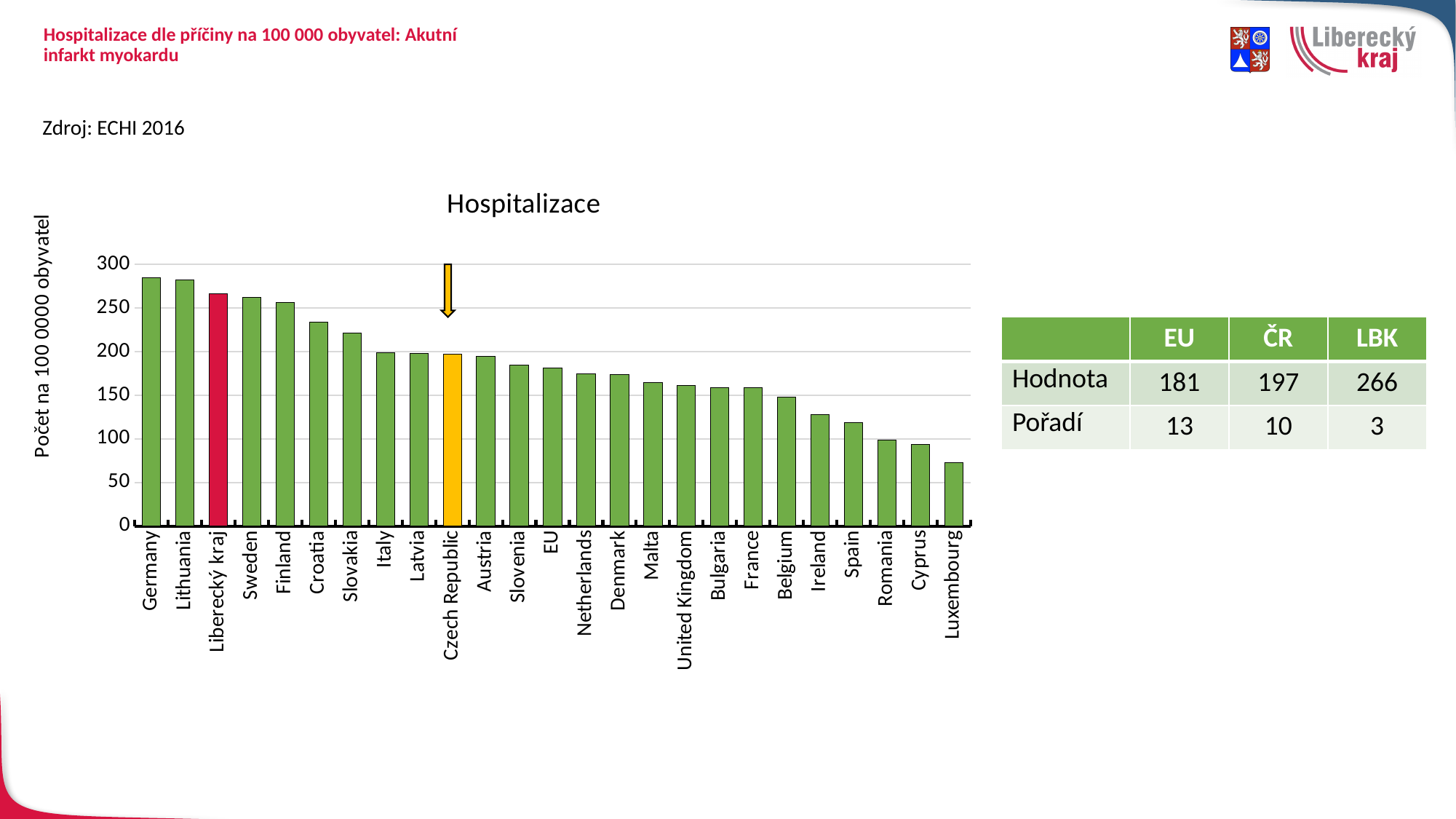
What is the difference between the values for Liberecký kraj and Czech Republic? 69 What is the value for Liberecký kraj in the Hospitalizace chart? 266 Do the values rise or fall from left to right along the x axis? fall How many categories are shown on the x axis of the Hospitalizace chart? 25 Is the value for Croatia greater or less than 200? greater Which has a larger value, Croatia or Slovakia? Croatia Which category has the lowest value in the Hospitalizace chart? Luxembourg What is the value for Czech Republic in the Hospitalizace chart? 197 Is the value for Ireland greater or less than 150? less What is the value for EU in the Hospitalizace chart? 181 What type of chart is shown on the slide? bar chart What is the difference between the values for Czech Republic and EU? 16